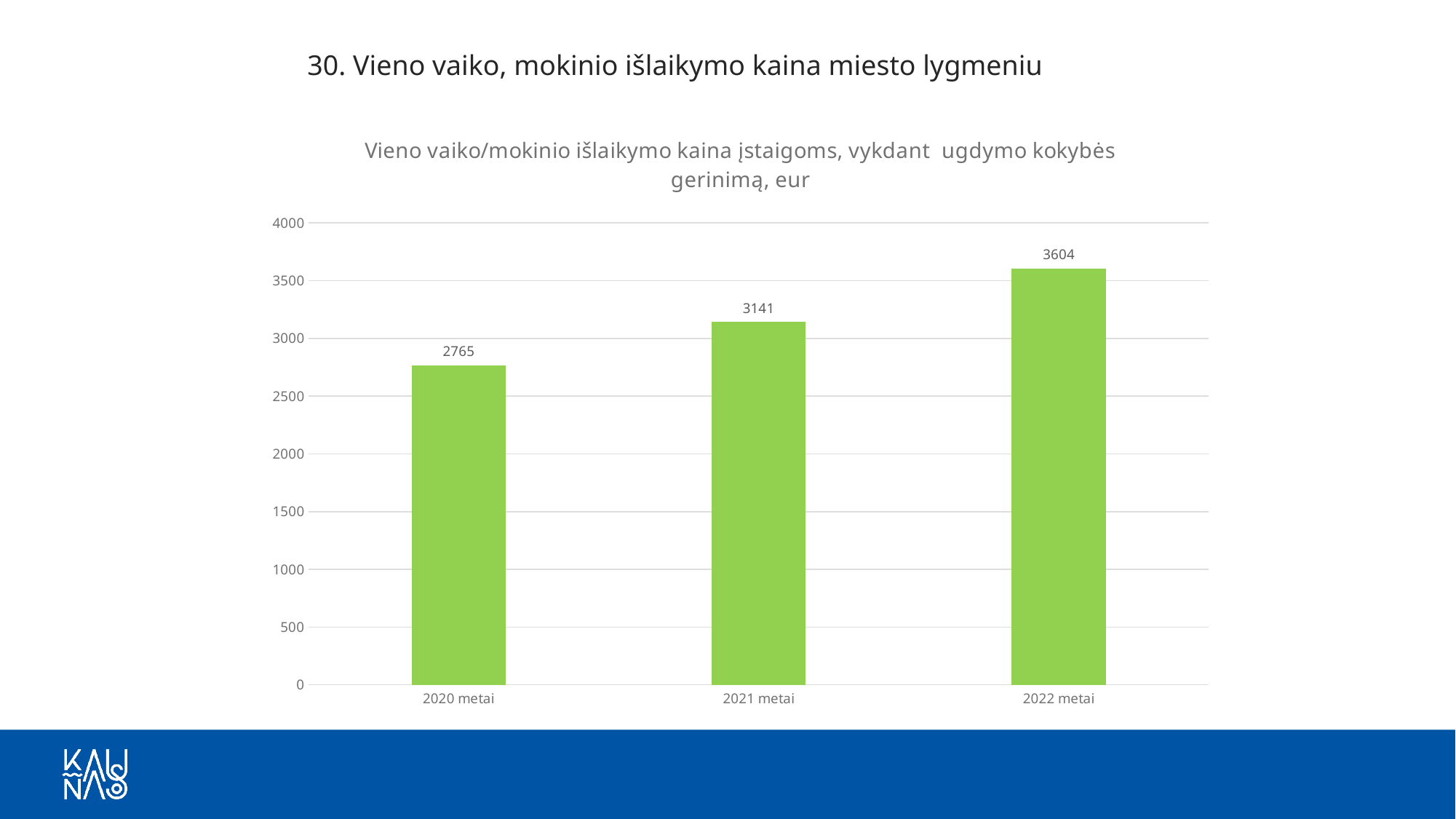
Which year has the lowest value? 2020 metai How many categories are shown on the x axis? 3 Which year has the highest value? 2022 metai What is the difference between the values for 2021 metai and 2020 metai? 376 What kind of chart is shown on the slide? bar chart Which is larger, the value for 2021 metai or the value for 2022 metai? 2022 metai What is the value for 2020 metai? 2765 Is the value for 2021 metai greater or less than 3000? greater Do the values rise or fall from 2020 metai to 2022 metai? rise What is the value for 2022 metai? 3604 What is the difference between the values for 2022 metai and 2020 metai? 839 What is the value for 2021 metai? 3141